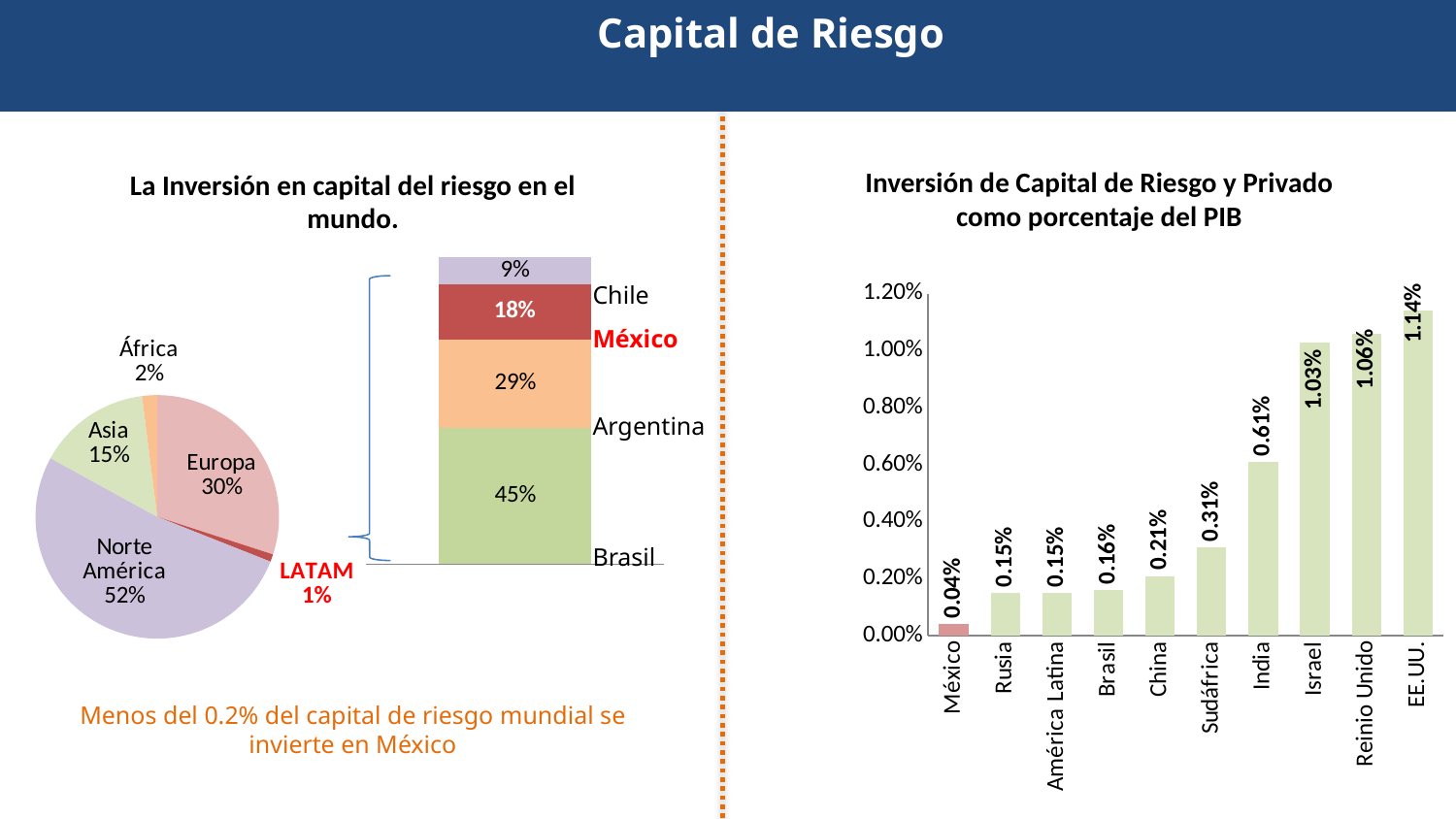
In the chart 'Inversión de Capital de Riesgo y Privado como porcentaje del PIB', how many countries or regions are shown on the x axis? 10 In the chart 'Inversión de Capital de Riesgo y Privado como porcentaje del PIB', what is the value for India? 0.61% In the chart 'Inversión de Capital de Riesgo y Privado como porcentaje del PIB', which country has the lowest value? México What kind of chart is 'Inversión de Capital de Riesgo y Privado como porcentaje del PIB'? bar chart In the chart 'Inversión de Capital de Riesgo y Privado como porcentaje del PIB', what is the value for Sudáfrica? 0.31% In the pie chart 'La Inversión en capital del riesgo en el mundo', which is larger, Europa or Asia? Europa In the chart 'Inversión de Capital de Riesgo y Privado como porcentaje del PIB', what is the difference between the values for EE.UU. and Israel? 0.11% In the chart 'Inversión de Capital de Riesgo y Privado como porcentaje del PIB', which country has the highest value? EE.UU. In the stacked bar showing the LATAM breakdown, what is the value for México? 18% In the chart 'Inversión de Capital de Riesgo y Privado como porcentaje del PIB', do the values generally rise or fall from left to right? rise In the pie chart 'La Inversión en capital del riesgo en el mundo', what share does Norte América have? 52% In the pie chart 'La Inversión en capital del riesgo en el mundo', which region has the smallest share? LATAM